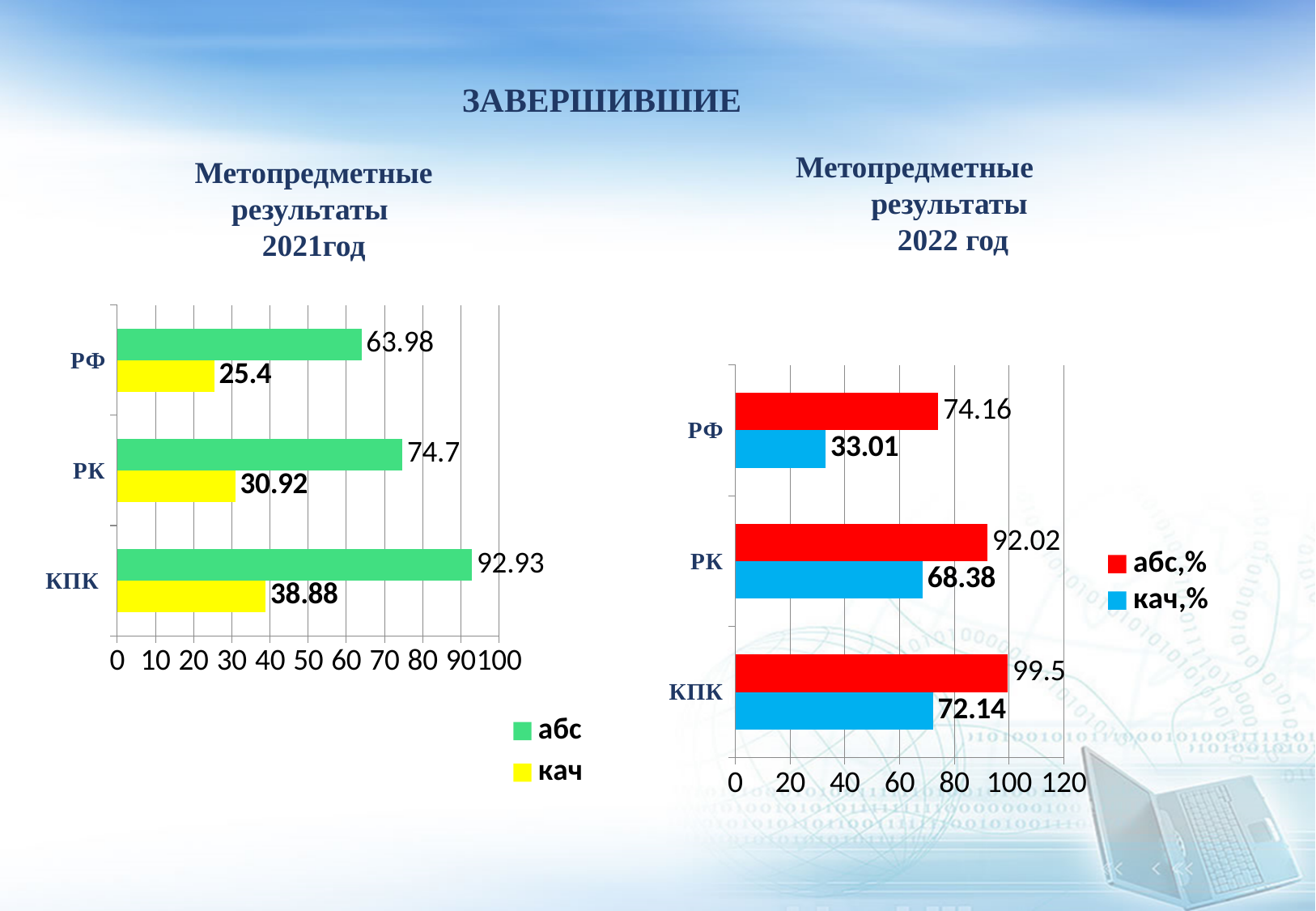
In the 2021 chart, what is the кач value for КПК? 38.88 How many series does the legend of the 2021 chart list? 2 What type of chart is the 2022 chart (Метопредметные результаты 2022 год)? Bar chart In the 2022 chart, what is the абс,% value for КПК? 99.5 In the 2021 chart, what is the difference between the абс and кач values for РК? 43.78 In the 2021 chart, which category has the highest абс value? КПК In the 2022 chart, what is the difference between the абс,% values for КПК and РФ? 25.34 In the 2022 chart, which category has the lowest кач,% value? РФ Which is larger: the кач value for РК in the 2021 chart or the кач,% value for РК in the 2022 chart? кач,% for РК in the 2022 chart How many categories are shown in the 2022 chart? 3 In the 2022 chart (Метопредметные результаты 2022 год), what is the кач,% value for РК? 68.38 In the 2021 chart (Метопредметные результаты 2021год), what is the абс value for РФ? 63.98